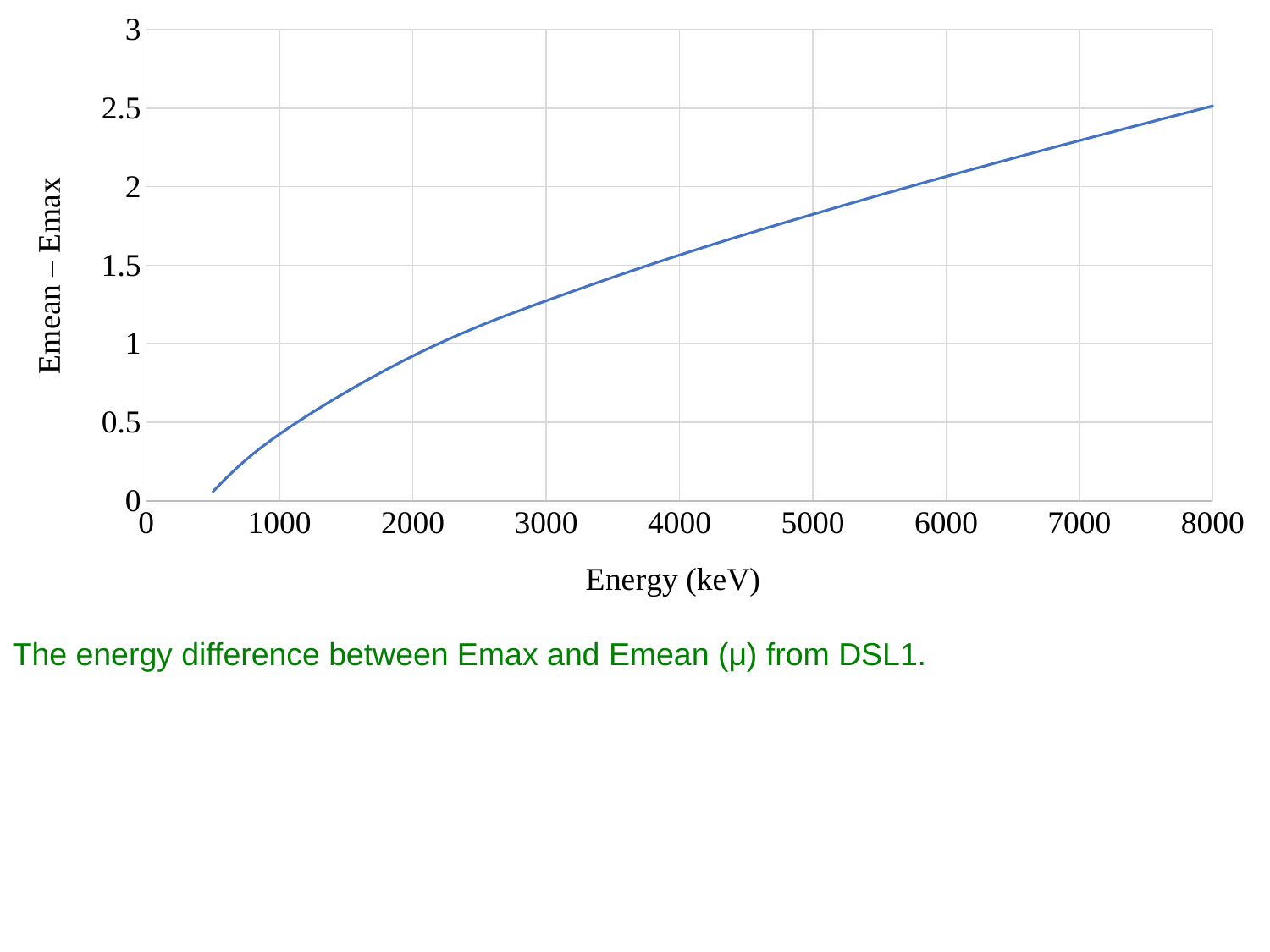
Is the value of Emean – Emax at 7000 keV greater or less than 2? greater Is the value of Emean – Emax at 2000 keV greater or less than 1? less What is the label of the y axis? Emean – Emax Does the value of Emean – Emax rise or fall as Energy (keV) increases? rise Is the value of Emean – Emax at 5000 keV greater or less than 2? less What is the label of the x axis? Energy (keV) What kind of chart is shown on the slide? line chart